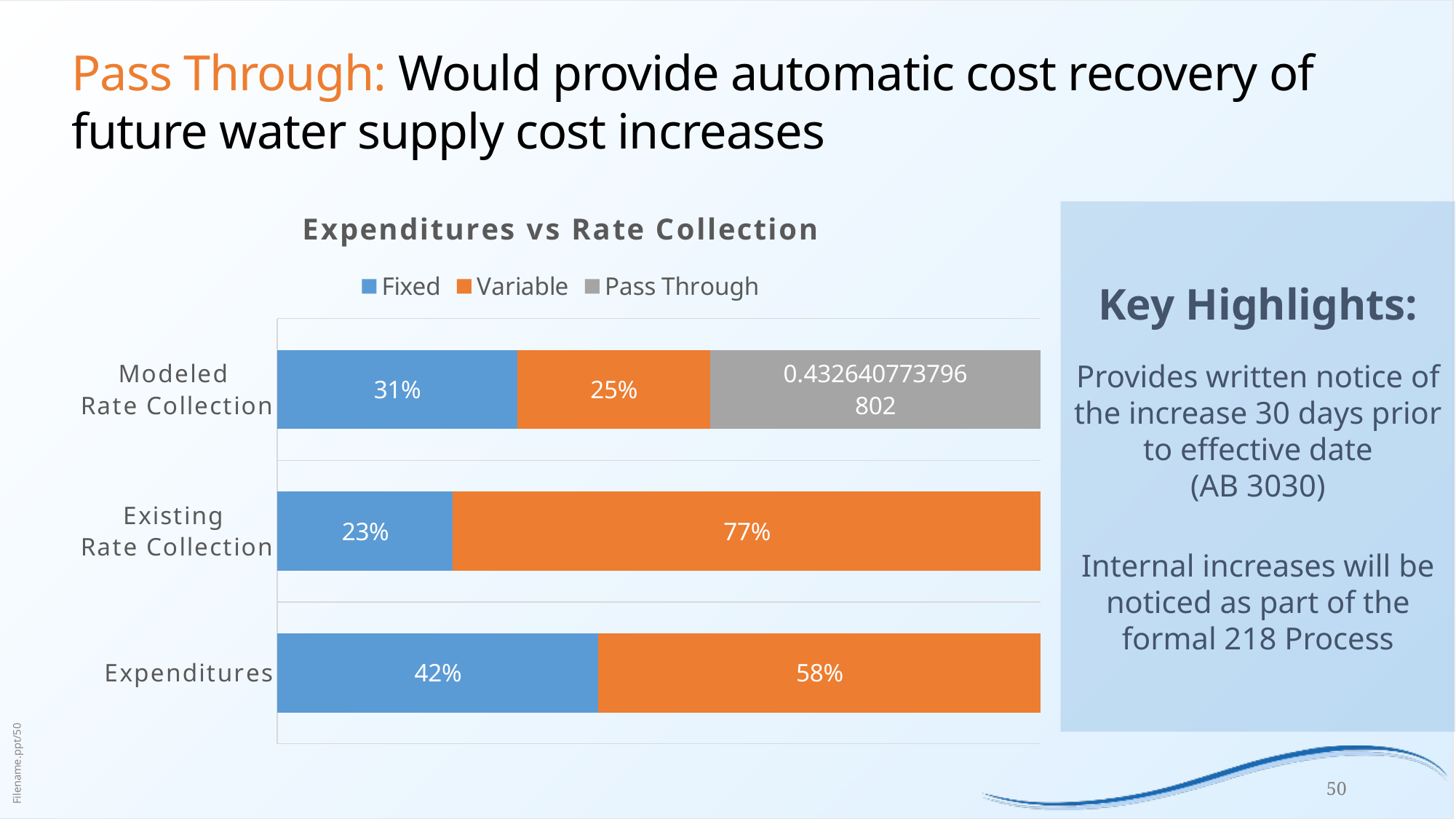
What is the Variable value for Existing Rate Collection? 77% How many series does the legend list? 3 What is the Fixed value for Existing Rate Collection? 23% What is the Fixed value for Modeled Rate Collection? 31% What is the difference between the Variable values for Existing Rate Collection and Expenditures? 19% Which category has the highest Fixed value? Expenditures How many categories are shown on the chart? 3 Is the Fixed value larger for Expenditures or for Modeled Rate Collection? Expenditures What is the Variable value for Modeled Rate Collection? 25% Which category has the lowest Fixed value? Existing Rate Collection What kind of chart is shown on the slide? Stacked bar chart What is the Fixed value for Expenditures in the Expenditures vs Rate Collection chart? 42%